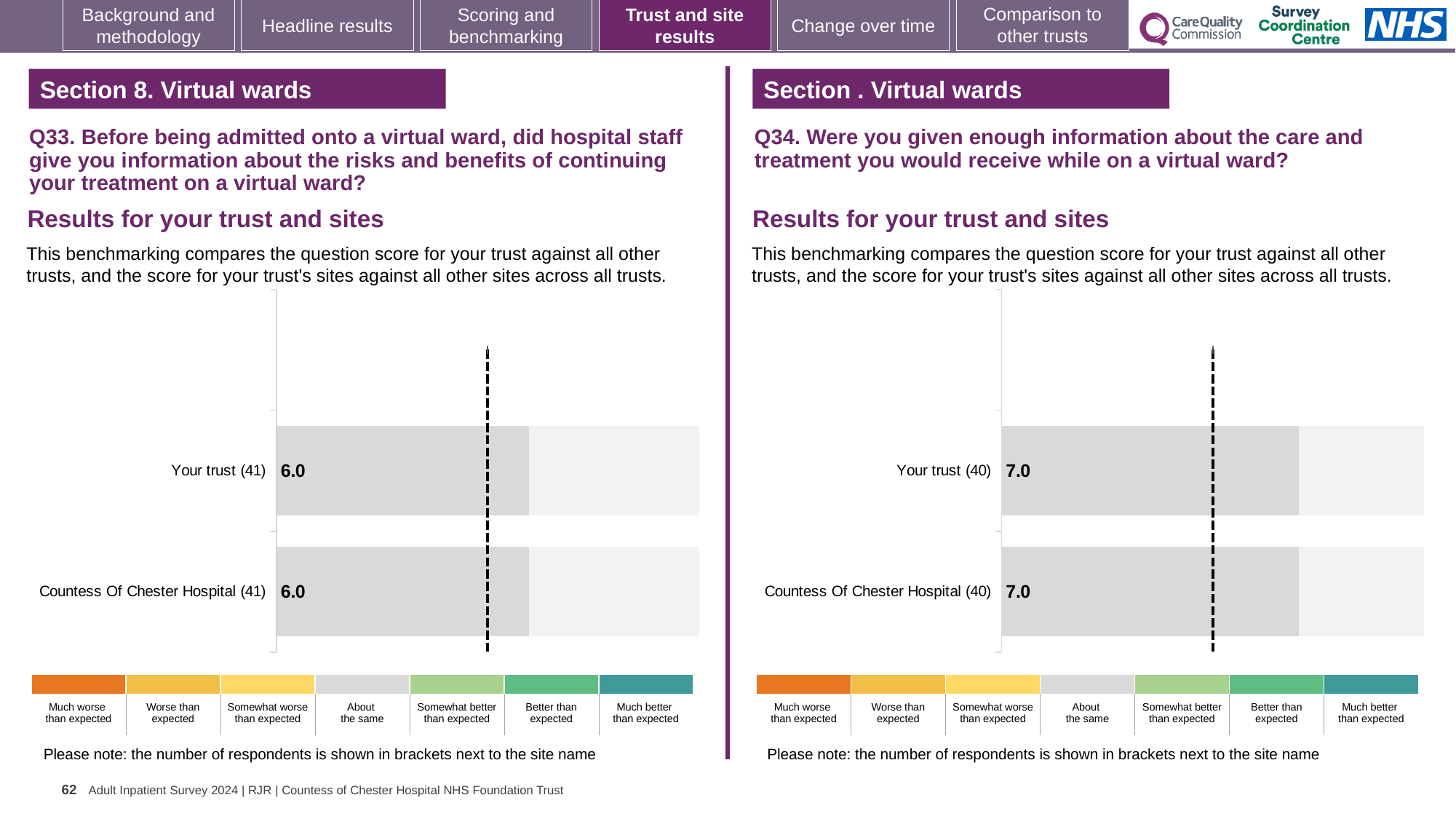
On the left chart (Q33), what is the score for Countess Of Chester Hospital? 6.0 How many bars are plotted on the right chart (Q34)? 2 On the left chart (Q33), what is the score for Your trust? 6.0 What kind of chart is used on the left (Q33)? Bar chart On the right chart (Q34), what is the score for Countess Of Chester Hospital? 7.0 Is the score for Your trust on the right chart (Q34) larger than the score for Your trust on the left chart (Q33)? Yes On the right chart (Q34), how many respondents are shown in brackets next to Countess Of Chester Hospital? 40 On the right chart (Q34), what is the score for Your trust? 7.0 On the left chart (Q33), how many respondents are shown in brackets next to Your trust? 41 On the left chart (Q33), what is the difference between the score for Your trust and the score for Countess Of Chester Hospital? 0.0 How many bars are plotted on the left chart (Q33)? 2 On the right chart (Q34), what is the difference between the score for Your trust and the score for Countess Of Chester Hospital? 0.0